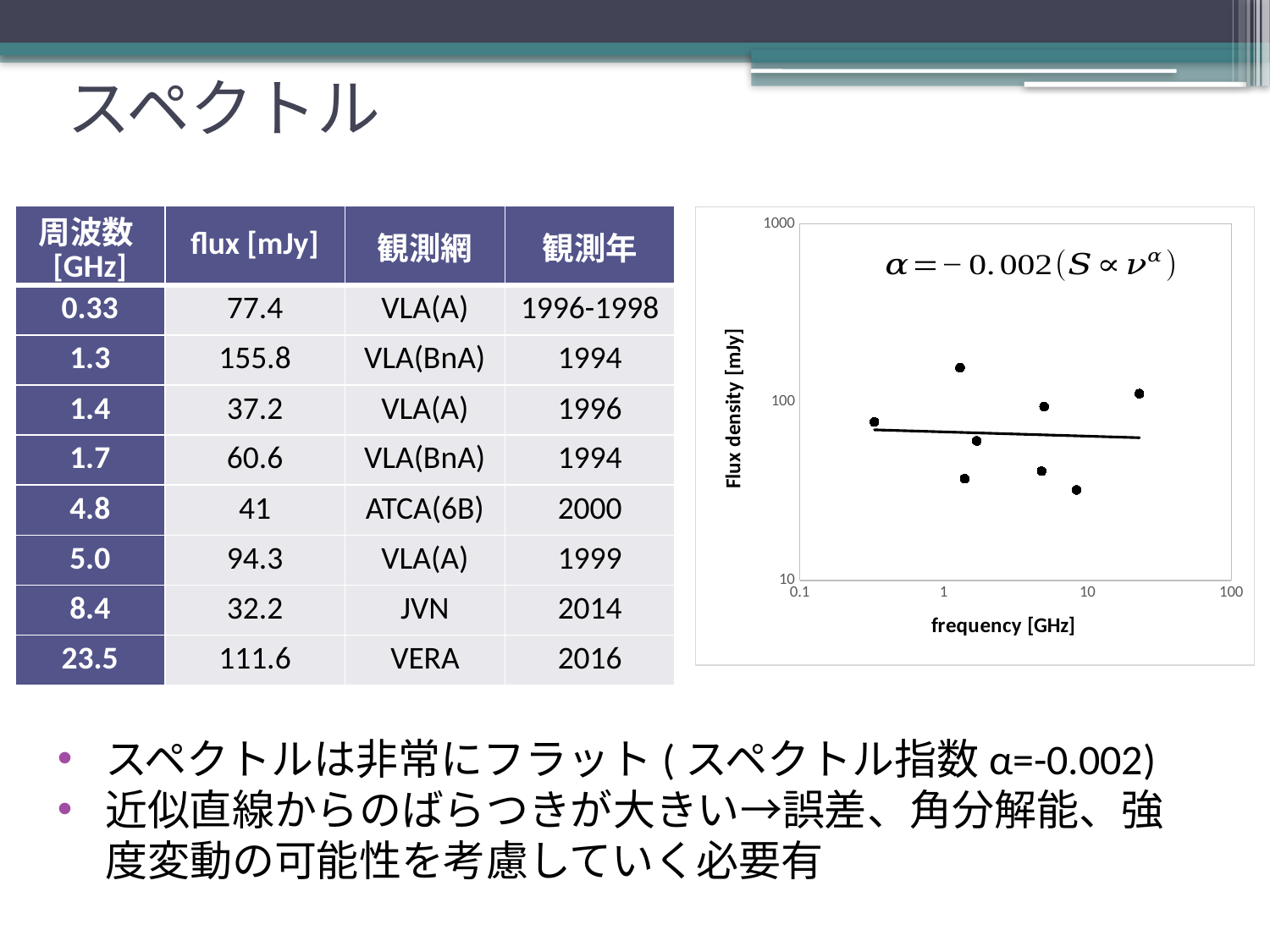
According to the table, what is the flux in mJy at 23.5 GHz? 111.6 What is the label of the x axis of the chart? frequency [GHz] What value of the spectral index α is printed on the chart? -0.002 At which frequency is the plotted flux density highest? 1.3 GHz Is the flux density plotted at 1.3 GHz greater or less than 100 mJy? greater At which frequency is the plotted flux density lowest? 8.4 GHz Which has the larger flux density, the point at 1.3 GHz or the point at 1.4 GHz? 1.3 GHz How many data points are plotted in the flux density versus frequency chart? 8 What is the label of the y axis of the chart? Flux density [mJy] Is the flux density plotted at 8.4 GHz greater or less than 100 mJy? less What kind of chart is shown on the right of the slide? scatter chart Is the flux density plotted at 23.5 GHz greater or less than 100 mJy? greater